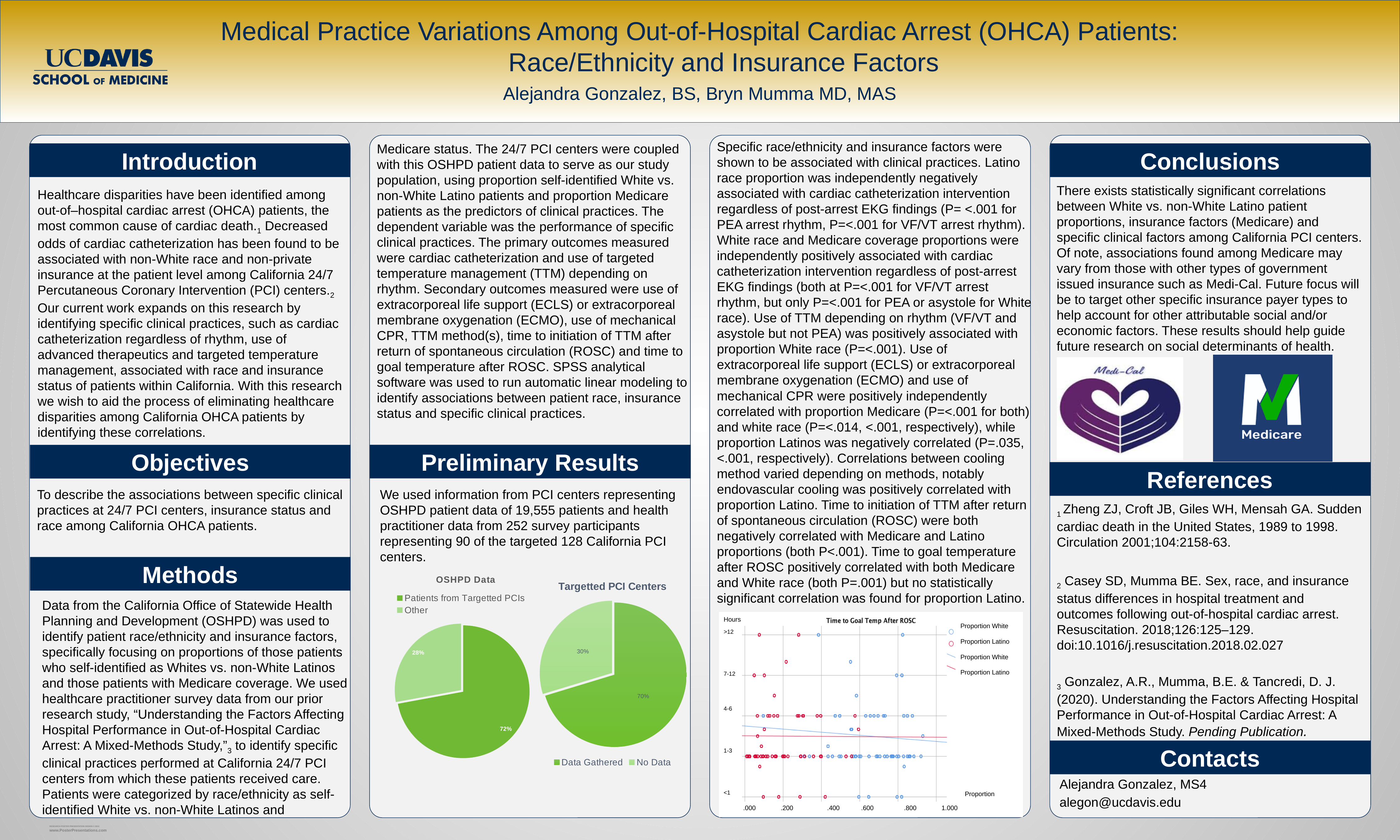
What kind of chart is the "OSHPD Data" chart? Pie chart What kind of chart is the "Time to Goal Temp After ROSC" chart? Scatter plot In the "Targetted PCI Centers" chart, what share of the pie is "No Data"? 30% In the "OSHPD Data" chart, which slice is the largest? Patients from Targetted PCIs In the "Targetted PCI Centers" chart, which slice is the smallest? No Data How many slices does the "Targetted PCI Centers" pie chart have? 2 In the "OSHPD Data" chart, what share of the pie is "Patients from Targetted PCIs"? 72% In the "OSHPD Data" chart, what share of the pie is "Other"? 28% In the "OSHPD Data" chart, what is the difference in percentage points between the "Patients from Targetted PCIs" slice and the "Other" slice? 44 In the "Time to Goal Temp After ROSC" chart, what is the label of the vertical axis? Hours In the "Targetted PCI Centers" chart, which is larger, "Data Gathered" or "No Data"? Data Gathered